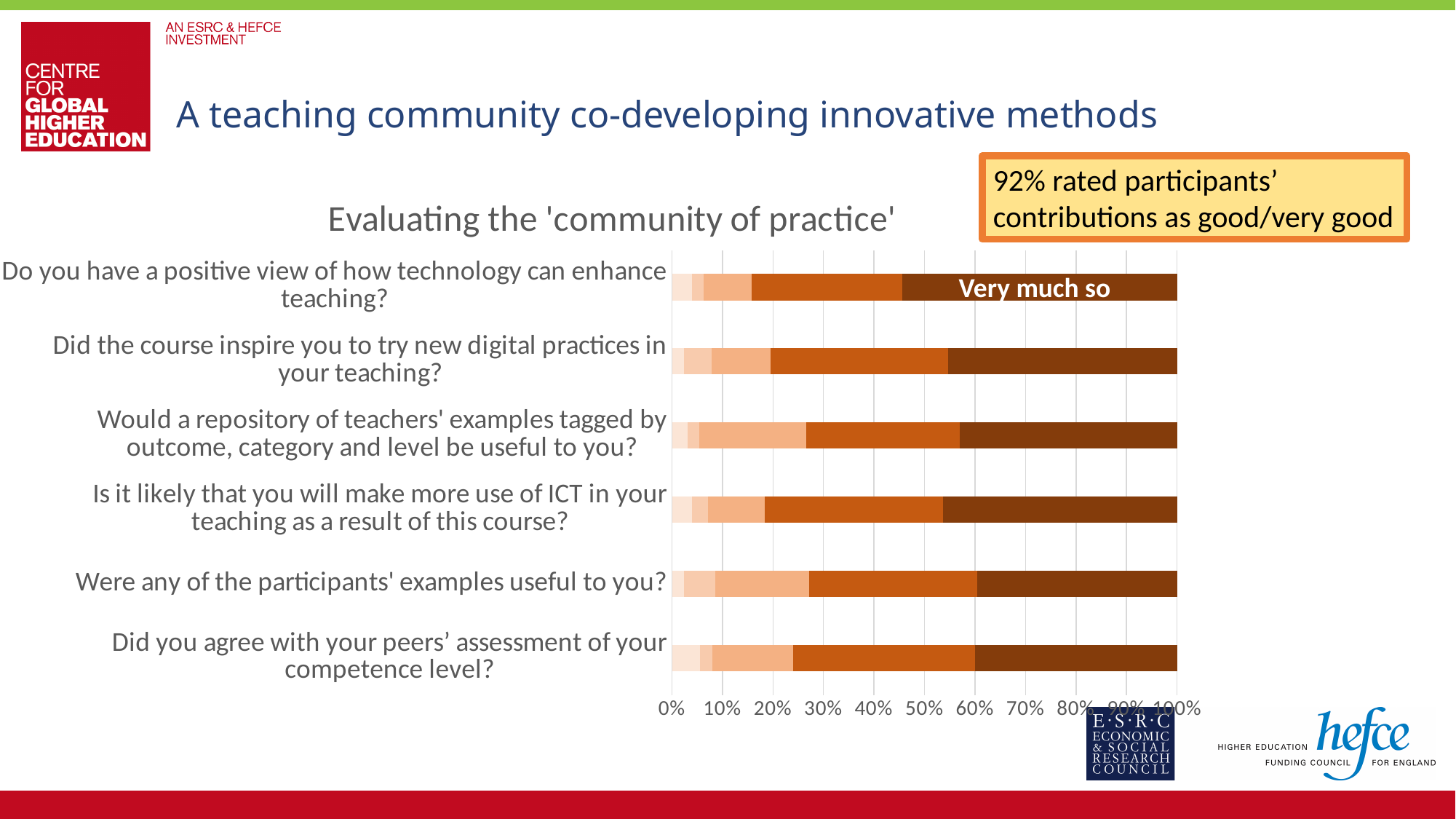
What is the maximum value shown on the horizontal axis? 100% Is the 'Very much so' share for 'Do you have a positive view of how technology can enhance teaching?' greater or less than 40%? greater What kind of chart is shown on the slide? Stacked bar chart Is the 'Very much so' share for 'Were any of the participants' examples useful to you?' greater or less than 50%? less Is the 'Very much so' share for 'Did you agree with your peers' assessment of your competence level?' greater or less than 30%? greater Which has the larger 'Very much so' segment: 'Do you have a positive view of how technology can enhance teaching?' or 'Were any of the participants' examples useful to you?' Do you have a positive view of how technology can enhance teaching? Which survey question has the largest 'Very much so' segment? Do you have a positive view of how technology can enhance teaching? What is the title of the chart? Evaluating the 'community of practice' How many survey questions (categories) are plotted in the chart? 6 What data label is printed on the darkest segment of the bar for 'Do you have a positive view of how technology can enhance teaching?' Very much so